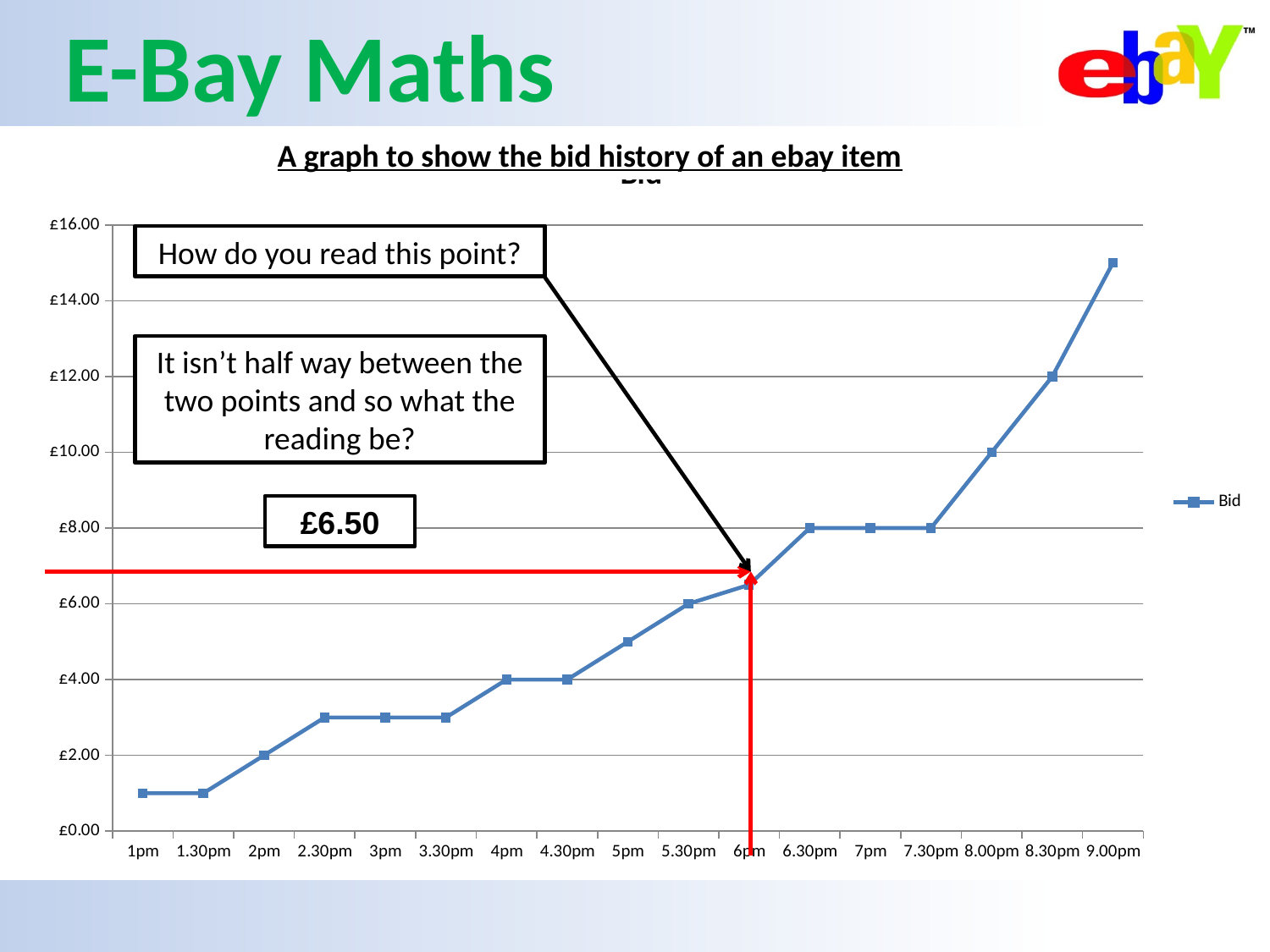
What is the bid value at 6pm, as annotated on the slide? £6.50 At which time is the bid highest? 9.00pm What is the difference between the bid at 8.30pm and the bid at 6.30pm? £4.00 How many time points are plotted on the x axis? 17 What series name does the legend show? Bid Is the bid value at 9.00pm greater or less than £14.00? greater What kind of chart is shown on the slide? line chart Do the bid values generally rise or fall from 1pm to 9.00pm? rise What is the bid value at 6.30pm? £8.00 What is the title of the graph? A graph to show the bid history of an ebay item What is the bid value at 8.30pm? £12.00 How many series does the legend list? 1